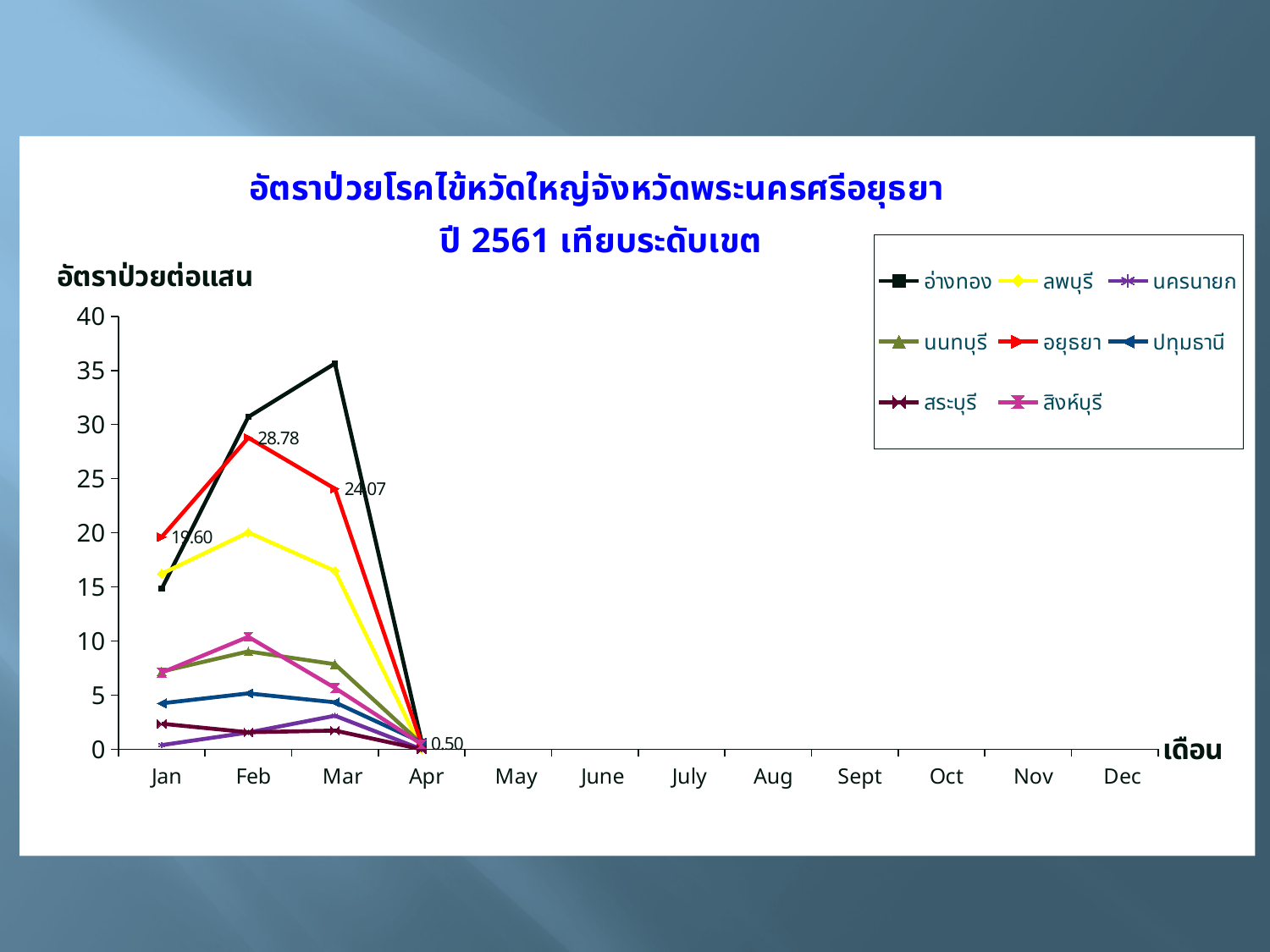
Is the value for อ่างทอง in Mar greater or less than 30? greater Which is larger in Feb, the value for อ่างทอง or the value for อยุธยา? อ่างทอง What kind of chart is shown on the slide? line chart How many series does the legend list? 8 What is the value for อยุธยา in Apr? 0.50 How many months are shown on the x axis? 12 In which month is the value for อยุธยา highest? Feb What is the value for อยุธยา in Mar? 24.07 What is the difference between the อยุธยา values for Feb and Mar? 4.71 What is the value for อยุธยา in Jan? 19.60 Does the value for อยุธยา rise or fall from Feb to Apr? fall What is the value for อยุธยา in Feb? 28.78